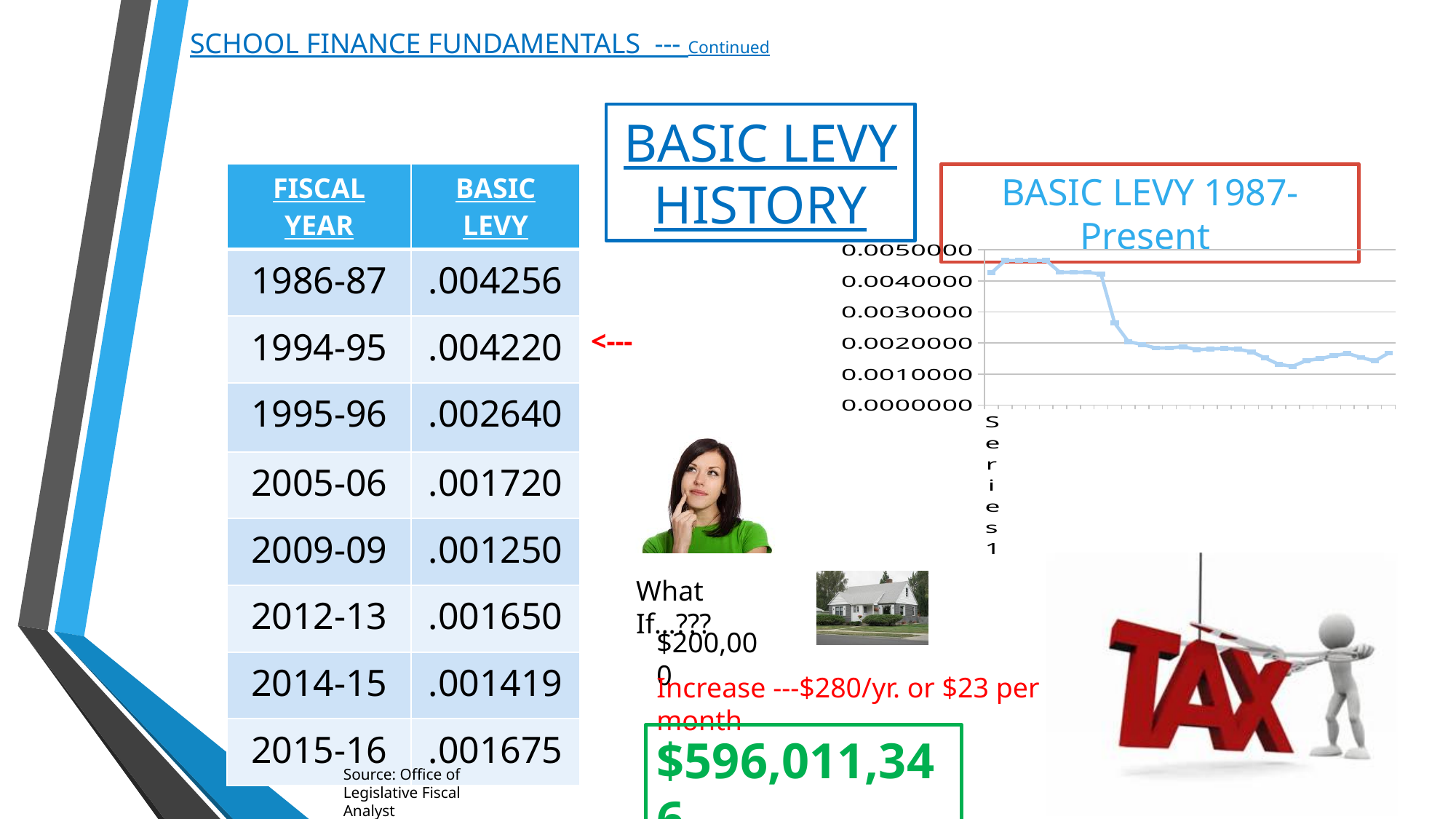
What kind of chart is shown on the slide? line chart Is the last (rightmost) value plotted on the chart greater or less than 0.0020000? less Is the first value on the chart larger or smaller than the last value on the chart? larger Is the highest value plotted on the chart greater or less than 0.0040000? greater Is the first (leftmost) value plotted on the chart greater or less than 0.0030000? greater What is the highest tick value shown on the chart's vertical axis? 0.0050000 What is the title of the chart on the slide? BASIC LEVY 1987-Present Do the values in the chart generally rise or fall from left to right along the x axis? fall